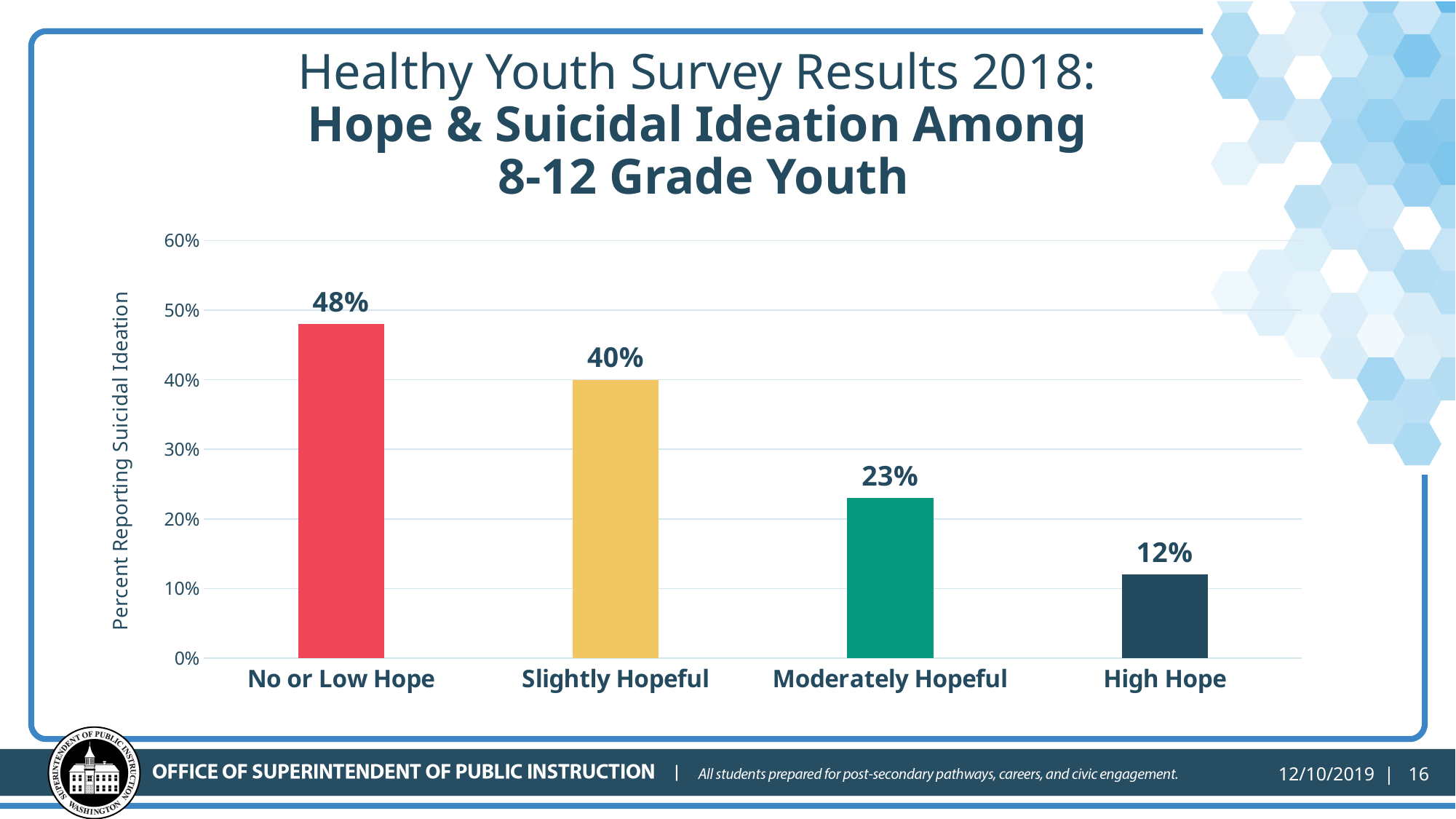
How many hope categories are shown on the x axis? 4 What is the difference in percentage points between No or Low Hope and High Hope? 36 What is the value for the Slightly Hopeful category? 40% What is the difference in percentage points between Slightly Hopeful and Moderately Hopeful? 17 What percent of youth with No or Low Hope reported suicidal ideation? 48% Which hope category has the highest percent reporting suicidal ideation? No or Low Hope What percent reporting suicidal ideation is shown for Moderately Hopeful youth? 23% Which hope category has the lowest percent reporting suicidal ideation? High Hope What kind of chart is shown on the slide? Bar chart Which is larger, the value for Slightly Hopeful or the value for Moderately Hopeful? Slightly Hopeful What is the value for the High Hope category? 12% Do the values rise or fall moving from No or Low Hope to High Hope along the x axis? Fall